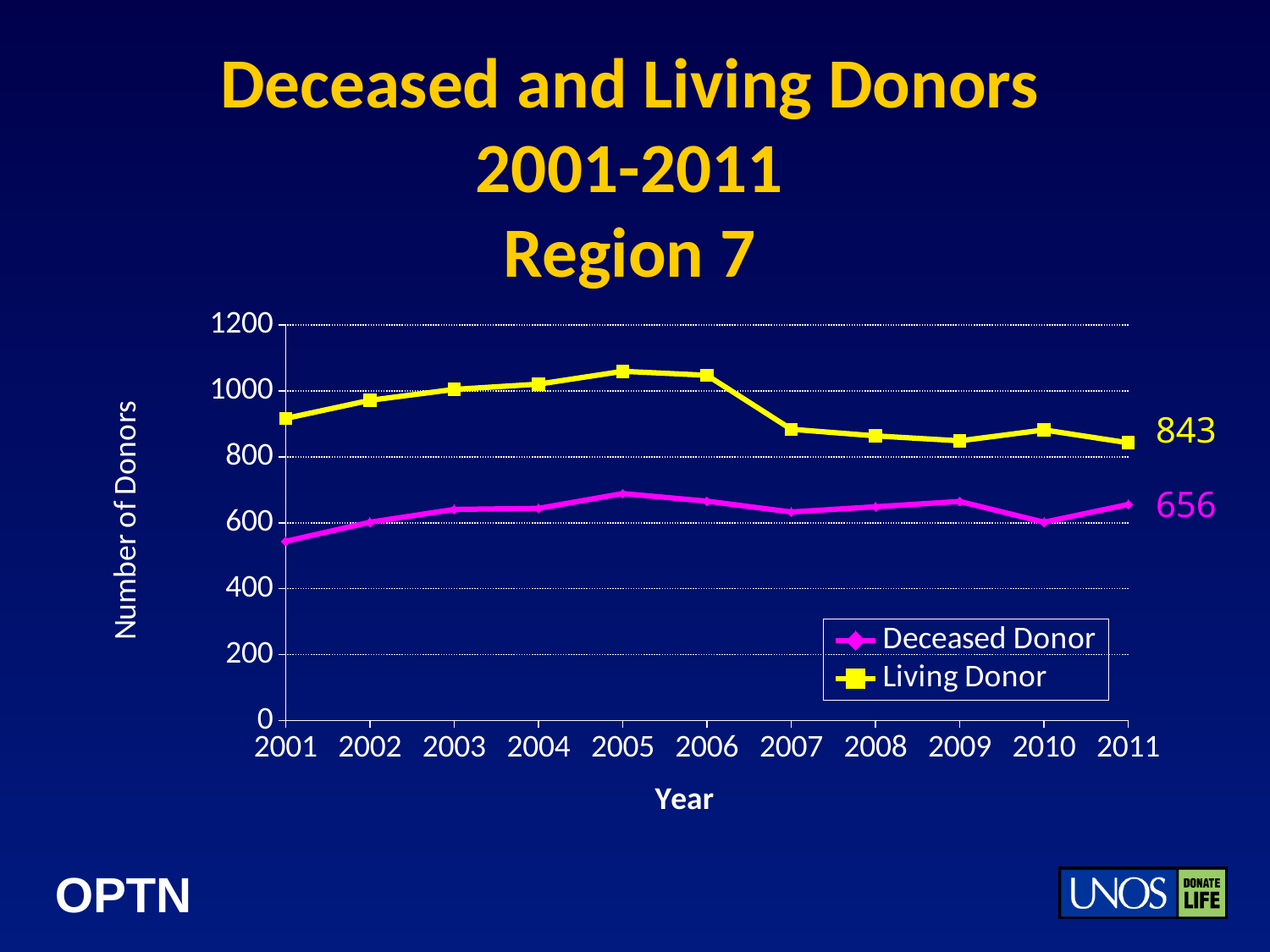
In which year does the Living Donor series reach its highest value? 2005 Which series has the larger value in 2011, Living Donor or Deceased Donor? Living Donor How many series does the legend list? 2 Does the Living Donor series rise or fall between 2006 and 2007? Fall What is the value for Living Donor in 2011? 843 In which year is the Deceased Donor series at its lowest? 2001 Is the Deceased Donor value for 2001 greater or less than 600? less Is the Living Donor value for 2005 greater or less than 1000? greater How many years are shown on the x axis? 11 What kind of chart is shown on the slide? Line chart What is the value for Deceased Donor in 2011? 656 What is the difference between the Living Donor and Deceased Donor values in 2011? 187